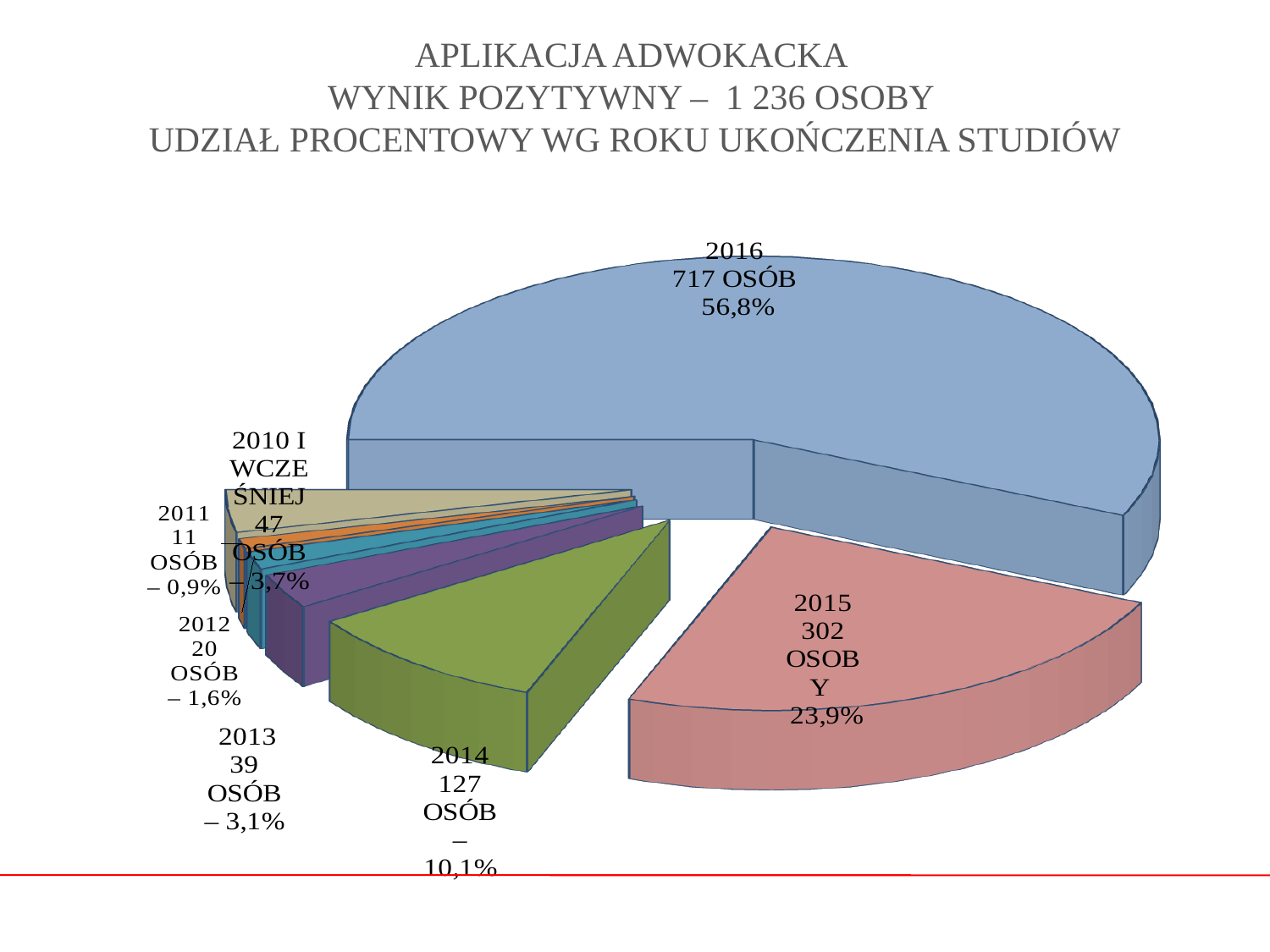
How many slices does the pie chart have? 7 Which category has the smallest slice of the pie? 2011 How many people are shown for 2014? 127 How many people (OSÓB) are shown for 2016? 717 Which year has the largest slice of the pie? 2016 Which has more people, 2012 or 2013? 2013 How many people are shown for the category '2010 I WCZEŚNIEJ'? 47 What is the difference in number of people between 2016 and 2015? 415 What total number of people is stated in the chart title? 1 236 What kind of chart is shown on the slide? pie chart What percentage share is shown for 2015? 23,9% What percentage share is shown for 2013? 3,1%